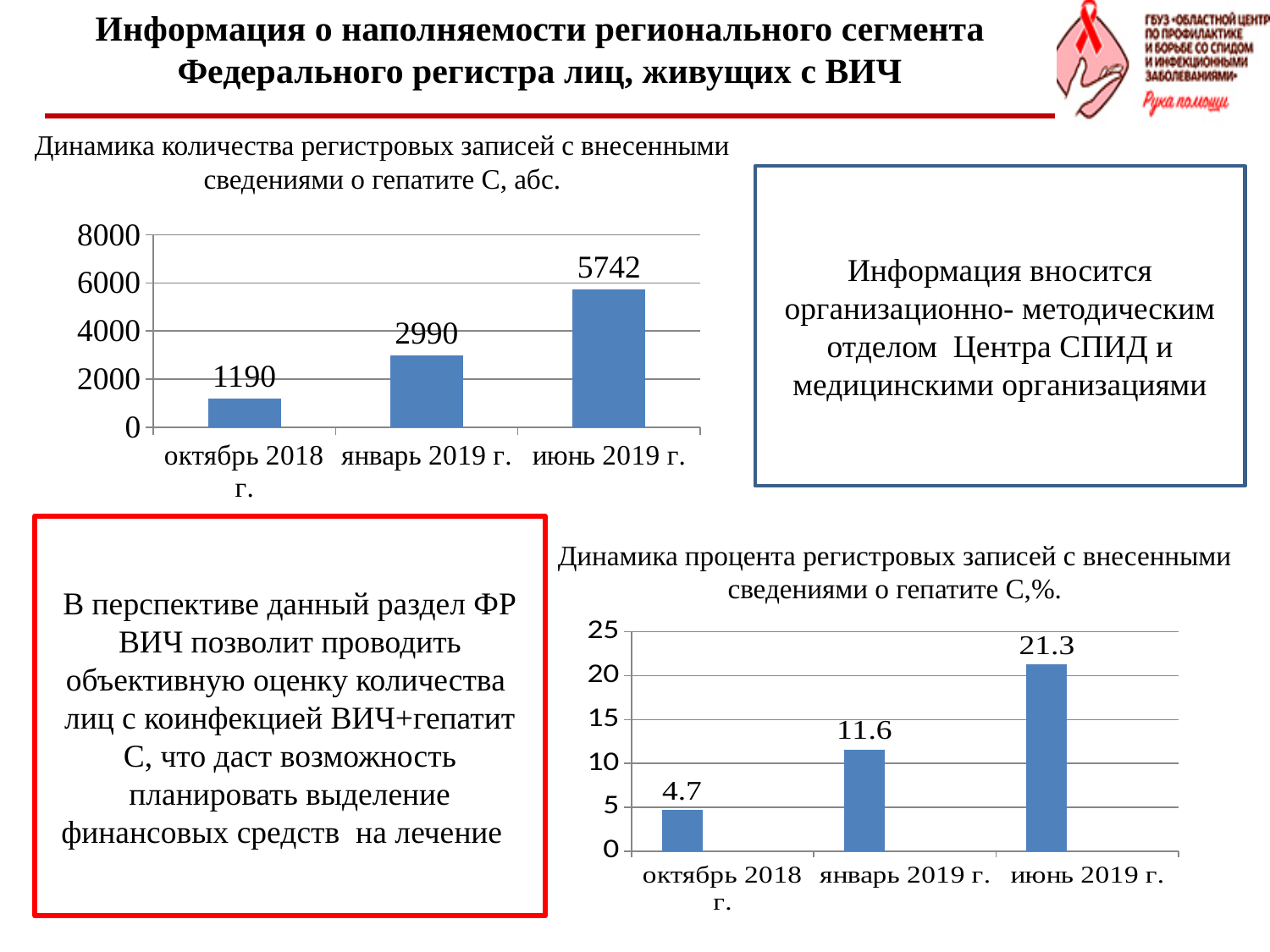
In the chart 'Динамика количества регистровых записей с внесенными сведениями о гепатите С, абс.', do the values rise or fall from октябрь 2018 г. to июнь 2019 г.? rise In the chart 'Динамика процента регистровых записей с внесенными сведениями о гепатите С,%.', is the value for июнь 2019 г. greater or less than 20? greater In the chart 'Динамика количества регистровых записей с внесенными сведениями о гепатите С, абс.', what is the difference between июнь 2019 г. and январь 2019 г.? 2752 In the chart 'Динамика количества регистровых записей с внесенными сведениями о гепатите С, абс.', what is the value for октябрь 2018 г.? 1190 In the chart 'Динамика процента регистровых записей с внесенными сведениями о гепатите С,%.', what is the difference between июнь 2019 г. and октябрь 2018 г.? 16.6 What type of chart is 'Динамика процента регистровых записей с внесенными сведениями о гепатите С,%.'? bar chart How many categories are shown in the chart 'Динамика количества регистровых записей с внесенными сведениями о гепатите С, абс.'? 3 In the chart 'Динамика количества регистровых записей с внесенными сведениями о гепатите С, абс.', what is the value for июнь 2019 г.? 5742 In the chart 'Динамика процента регистровых записей с внесенными сведениями о гепатите С,%.', which is larger: the value for январь 2019 г. or октябрь 2018 г.? январь 2019 г. In the chart 'Динамика количества регистровых записей с внесенными сведениями о гепатите С, абс.', which period has the lowest value? октябрь 2018 г. In the chart 'Динамика процента регистровых записей с внесенными сведениями о гепатите С,%.', what is the value for январь 2019 г.? 11.6 In the chart 'Динамика процента регистровых записей с внесенными сведениями о гепатите С,%.', which period has the highest value? июнь 2019 г.